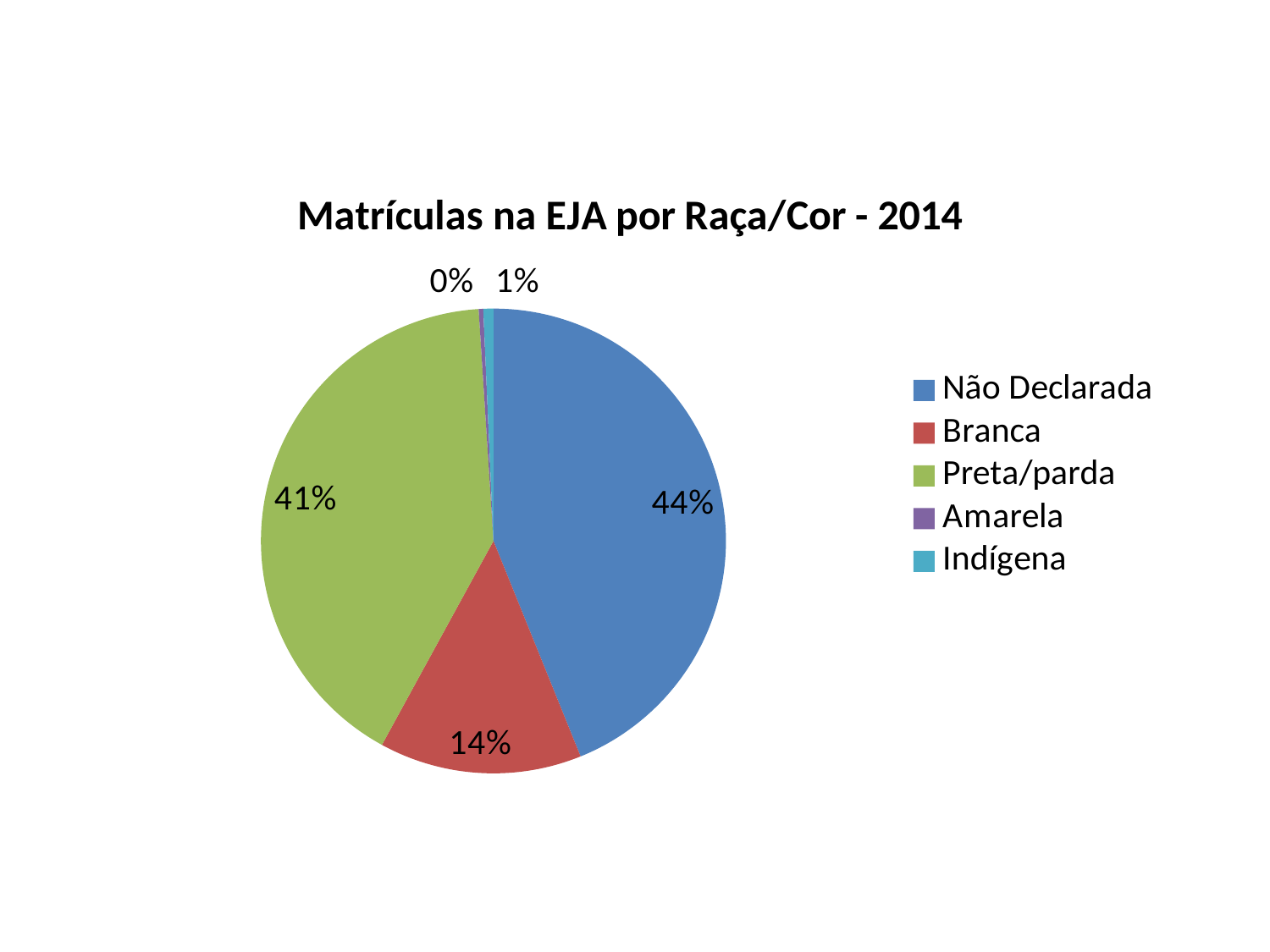
What share of the pie does Não Declarada represent? 44% Which category has the smallest share of the pie? Amarela What share of the pie does Indígena represent? 1% What is the difference in percentage points between Não Declarada and Branca? 30 What kind of chart is shown on the slide? pie chart What is the title of the chart? Matrículas na EJA por Raça/Cor - 2014 Which is larger, the share for Preta/parda or the share for Branca? Preta/parda Which category has the largest share of the pie? Não Declarada What share of the pie does Preta/parda represent? 41% How many categories does the legend list? 5